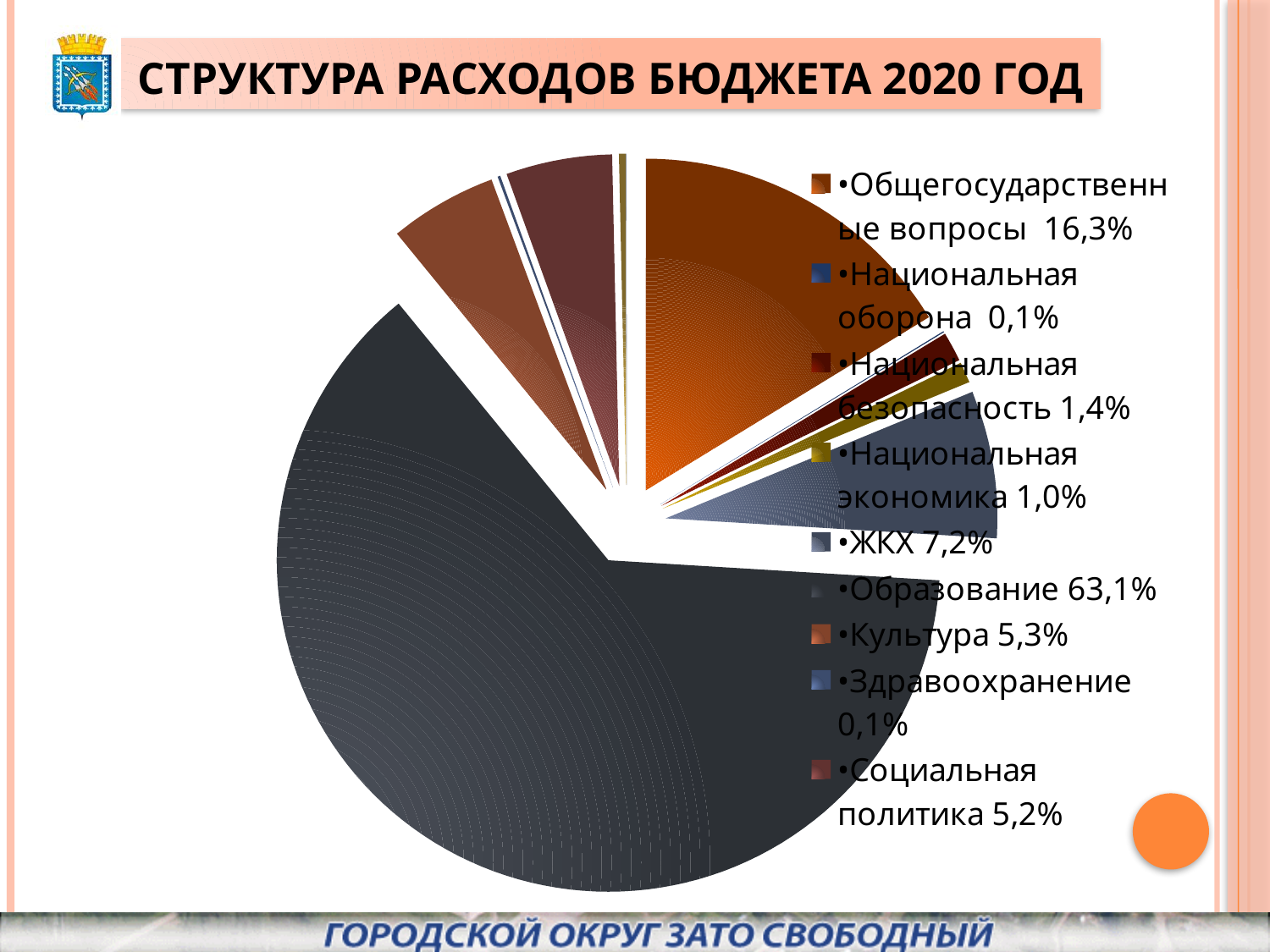
What share of the budget expenditure goes to Образование? 63,1% Which category has the largest share of the pie? Образование Which is larger, the share for ЖКХ or the share for Культура? ЖКХ What is the value shown for Национальная безопасность? 1,4% What is the difference between the shares of Образование and Общегосударственные вопросы? 46,8% What is the value shown for Социальная политика? 5,2% What is the difference between the shares of ЖКХ and Национальная экономика? 6,2% How many categories does the pie chart's legend list? 9 What kind of chart is shown on the slide? pie chart What is the value shown for Общегосударственные вопросы? 16,3% What is the title of the chart on the slide? СТРУКТУРА РАСХОДОВ БЮДЖЕТА 2020 ГОД What is the value shown for ЖКХ? 7,2%